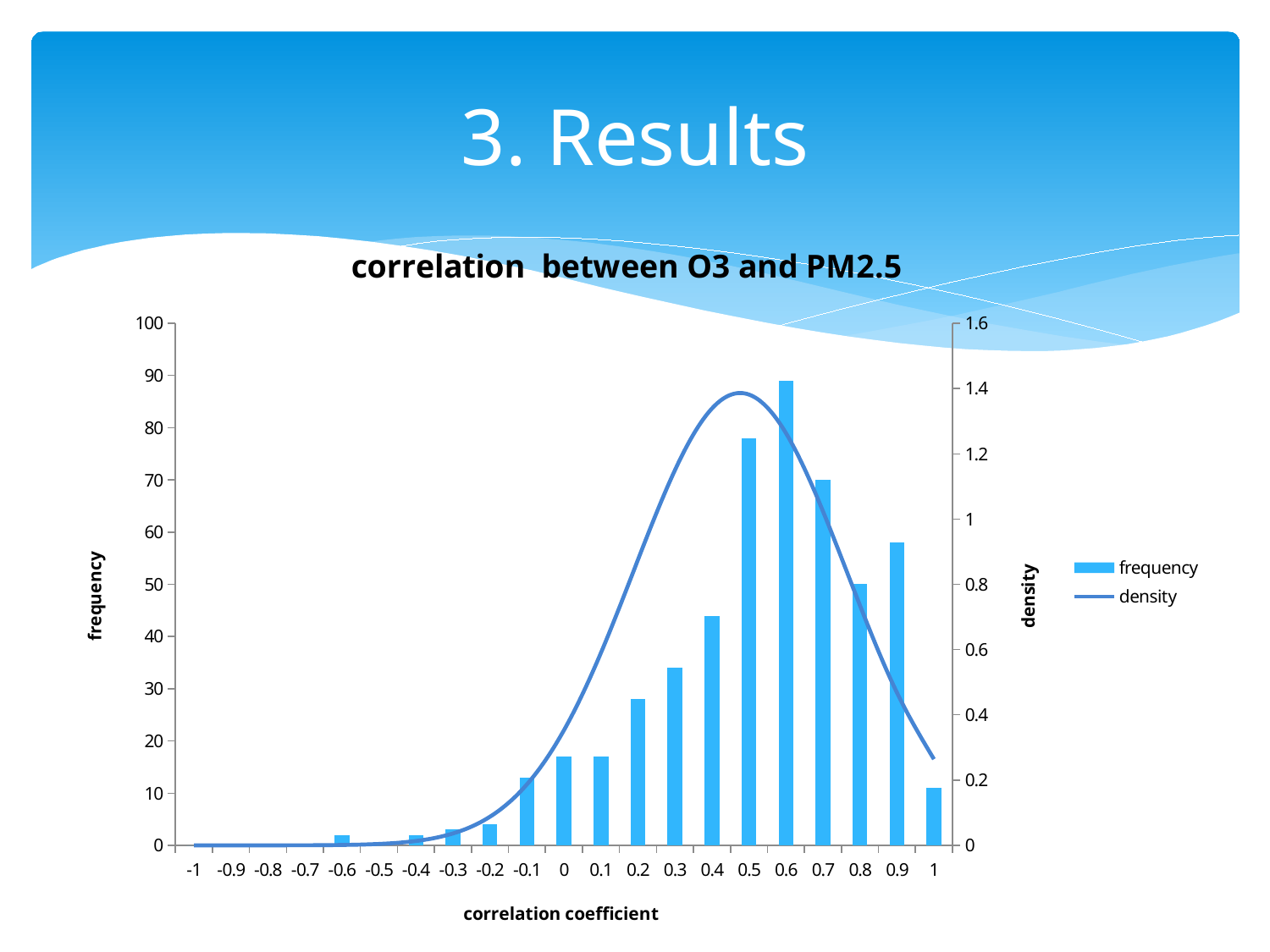
Is the frequency for correlation coefficient 0.4 greater or less than 50? less Is the frequency for correlation coefficient 1 greater or less than 20? less Is the frequency for correlation coefficient 0.6 greater or less than 80? greater How many series does the legend list? 2 What is the label of the right-hand vertical axis? density What are the two series named in the legend? frequency and density How many correlation coefficient categories are shown on the x axis? 21 What is the title of the chart? correlation between O3 and PM2.5 Which has a higher frequency, correlation coefficient 0.7 or 0.9? 0.7 Which correlation coefficient has the highest frequency bar? 0.6